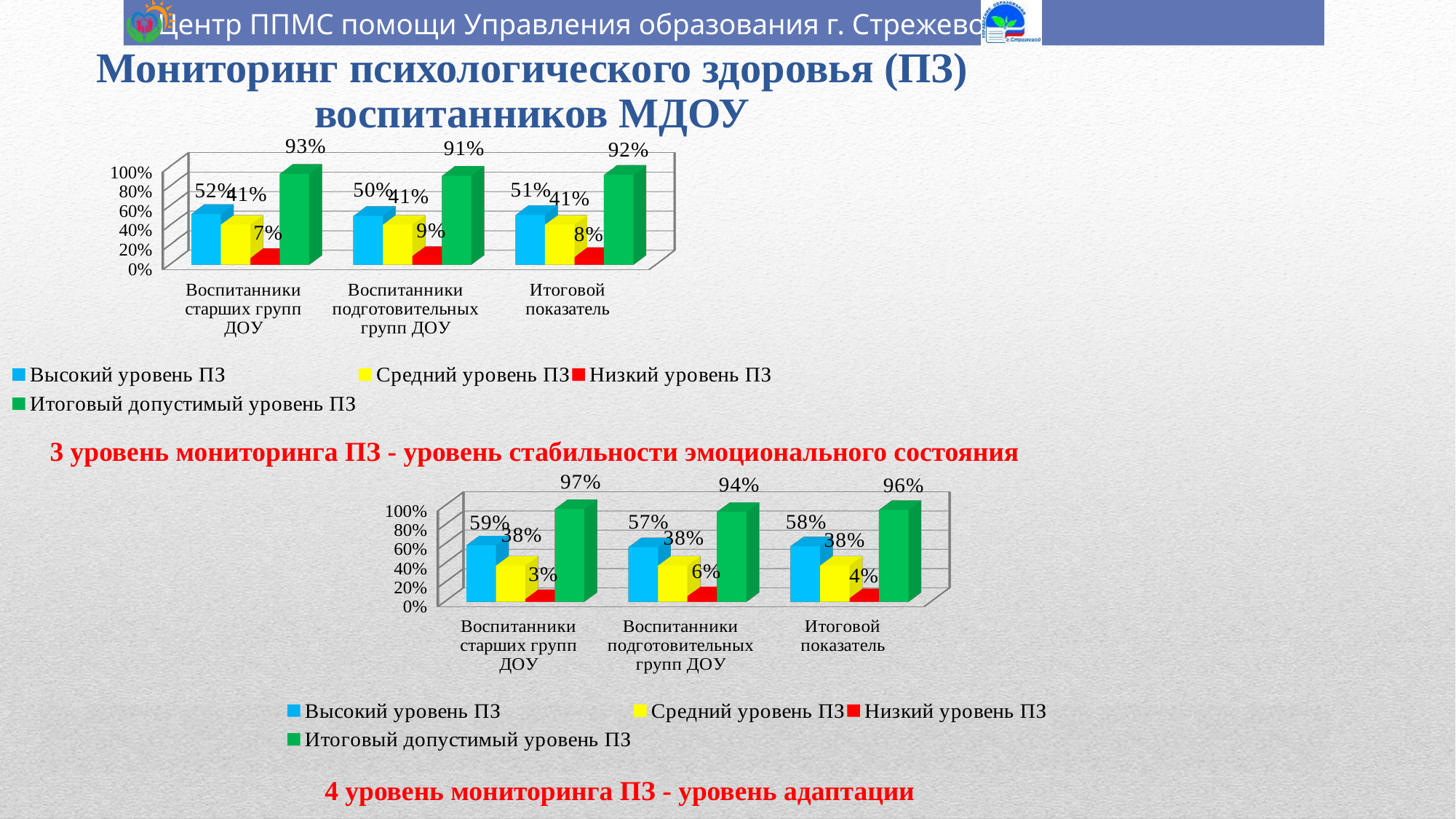
In the top chart, which category has the highest Итоговый допустимый уровень ПЗ value? Воспитанники старших групп ДОУ What type of chart is the bottom chart? bar chart In the bottom chart, is the Высокий уровень ПЗ value for Итоговой показатель larger or smaller than the Средний уровень ПЗ value for the same category? larger In the bottom chart, which category has the lowest Низкий уровень ПЗ value? Воспитанники старших групп ДОУ In the bottom chart, what is the value of Низкий уровень ПЗ for Воспитанники старших групп ДОУ? 3% How many series does the legend of the top chart list? 4 In the top chart, what is the Итоговый допустимый уровень ПЗ value for Итоговой показатель? 92% In the bottom chart, what is the Итоговый допустимый уровень ПЗ value for Воспитанники подготовительных групп ДОУ? 94% How many categories are shown on the x axis of the bottom chart? 3 In the top chart, what is the difference between Высокий уровень ПЗ and Средний уровень ПЗ for Итоговой показатель? 10% In the top chart, what is the value of Низкий уровень ПЗ for Воспитанники подготовительных групп ДОУ? 9% In the top chart, what is the value of Высокий уровень ПЗ for Воспитанники старших групп ДОУ? 52%